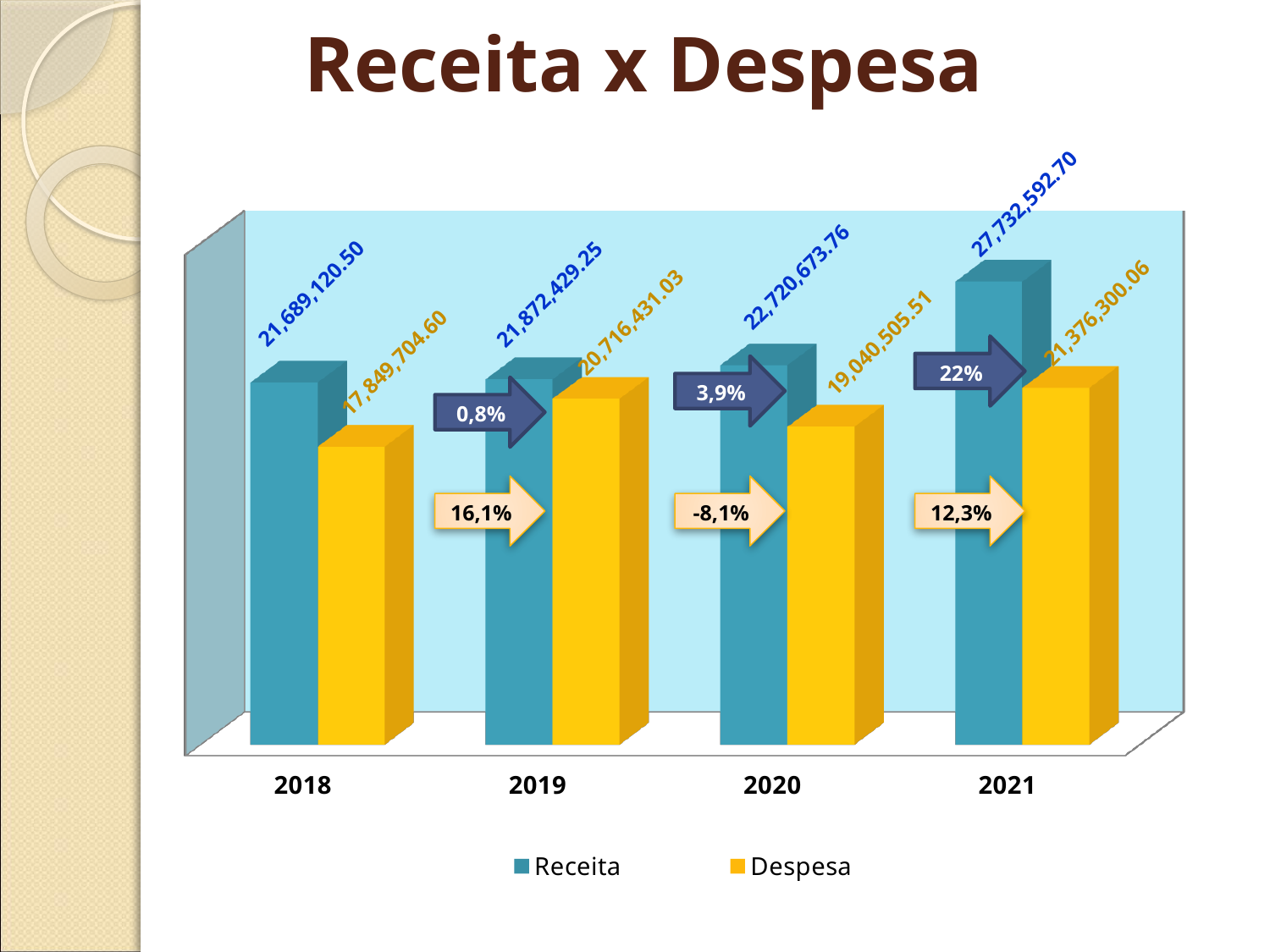
How many series does the legend list? 2 What is the Receita value for 2019? 21,872,429.25 What is the Despesa value for 2018? 17,849,704.60 How many years are shown on the x axis? 4 Which year has the lowest Despesa? 2018 What kind of chart is shown on the slide? Bar chart Which year has the highest Receita? 2021 What is the Despesa value for 2020? 19,040,505.51 What percentage change is shown in the arrow for Despesa between 2019 and 2020? -8,1% Which is larger in 2019, Receita or Despesa? Receita What is the difference between Receita and Despesa in 2021? 6,356,292.64 What is the Receita value for 2021? 27,732,592.70